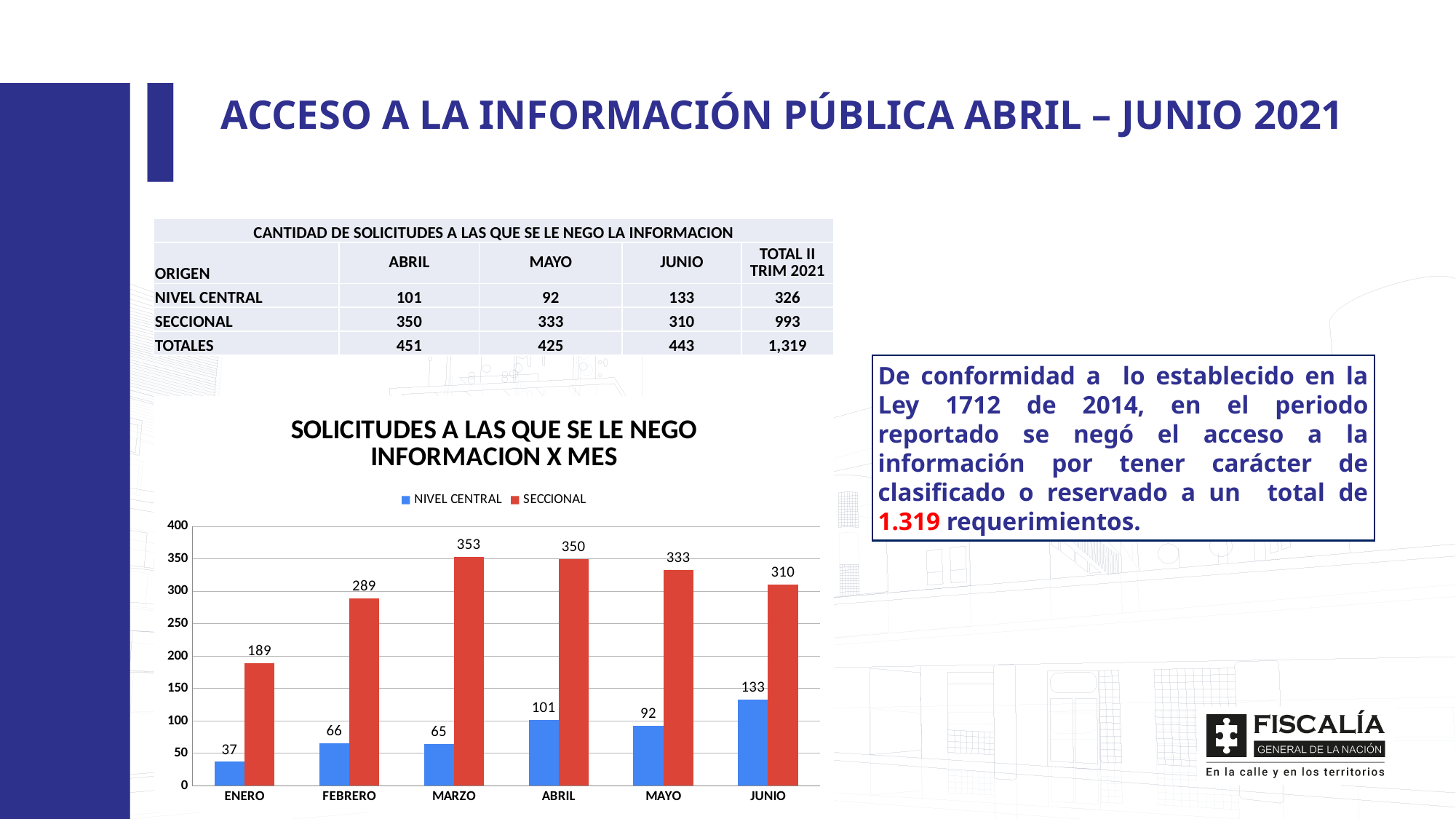
What is the value for NIVEL CENTRAL in ENERO? 37 Which month has the highest SECCIONAL value? MARZO Which is larger in MAYO, NIVEL CENTRAL or SECCIONAL? SECCIONAL What is the difference between the SECCIONAL and NIVEL CENTRAL values in ABRIL? 249 What is the title of the chart? SOLICITUDES A LAS QUE SE LE NEGO INFORMACION X MES What kind of chart is shown on the slide? Bar chart How many series does the chart legend list? 2 What is the value for SECCIONAL in MARZO? 353 Which month has the lowest NIVEL CENTRAL value? ENERO Does the NIVEL CENTRAL value rise or fall from ENERO to FEBRERO? Rise What is the value for NIVEL CENTRAL in JUNIO? 133 How many months are shown on the x axis of the chart? 6